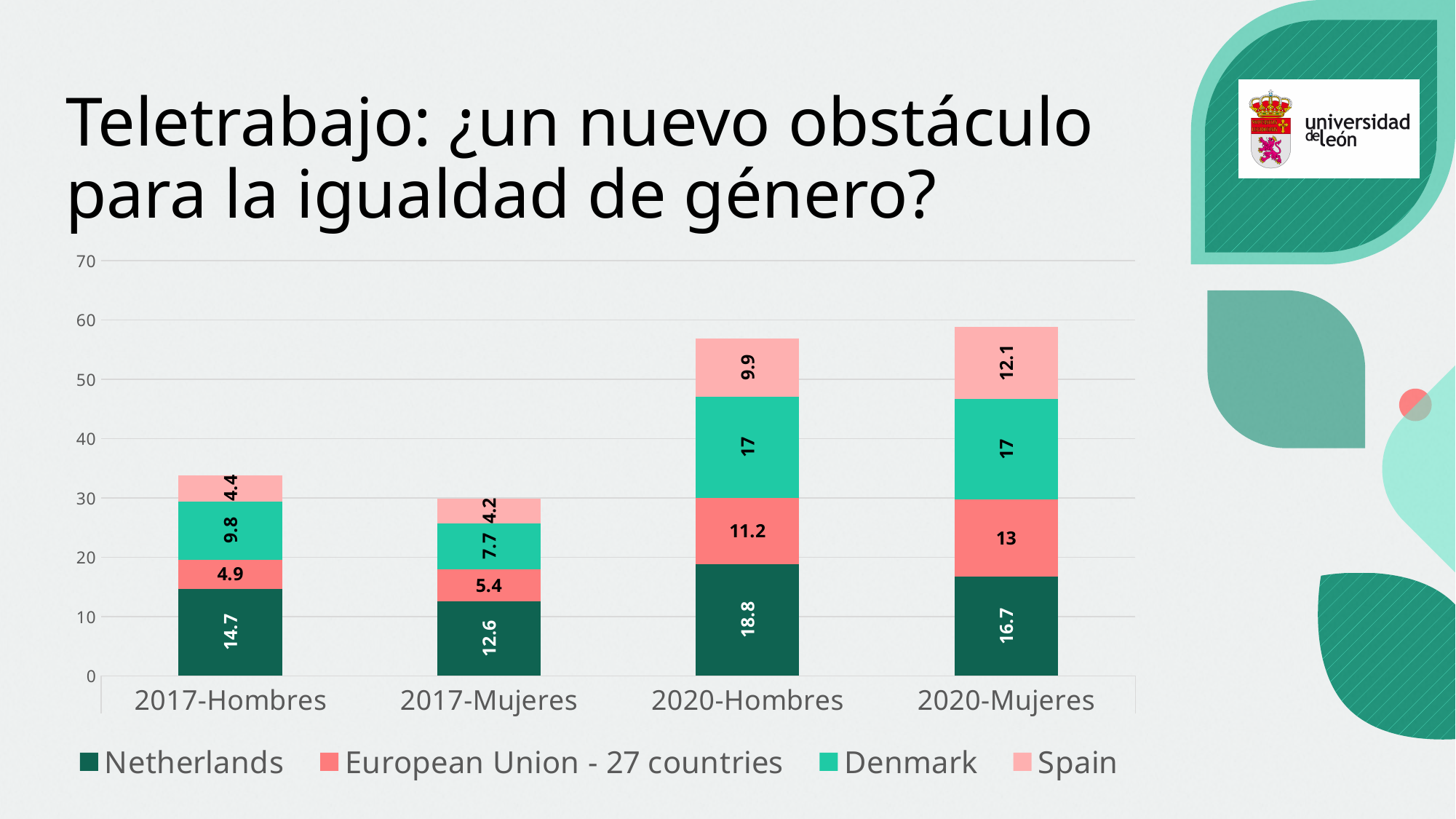
Which series is shown in the darkest green colour? Netherlands Which category has the highest value for Netherlands? 2020-Hombres What is the value for Spain in 2017-Mujeres? 4.2 What is the difference between the Denmark values for 2020-Hombres and 2017-Hombres? 7.2 What is the value for Netherlands in 2020-Hombres? 18.8 What is the total of the stacked bar for 2020-Mujeres? 58.8 What is the value for European Union - 27 countries in 2020-Mujeres? 13 What kind of chart is shown on the slide? Stacked bar chart How many series does the legend list? 4 Which category has the lowest value for Spain? 2017-Mujeres How many categories are shown on the x axis? 4 Which is larger: the European Union - 27 countries value for 2017-Hombres or for 2017-Mujeres? 2017-Mujeres